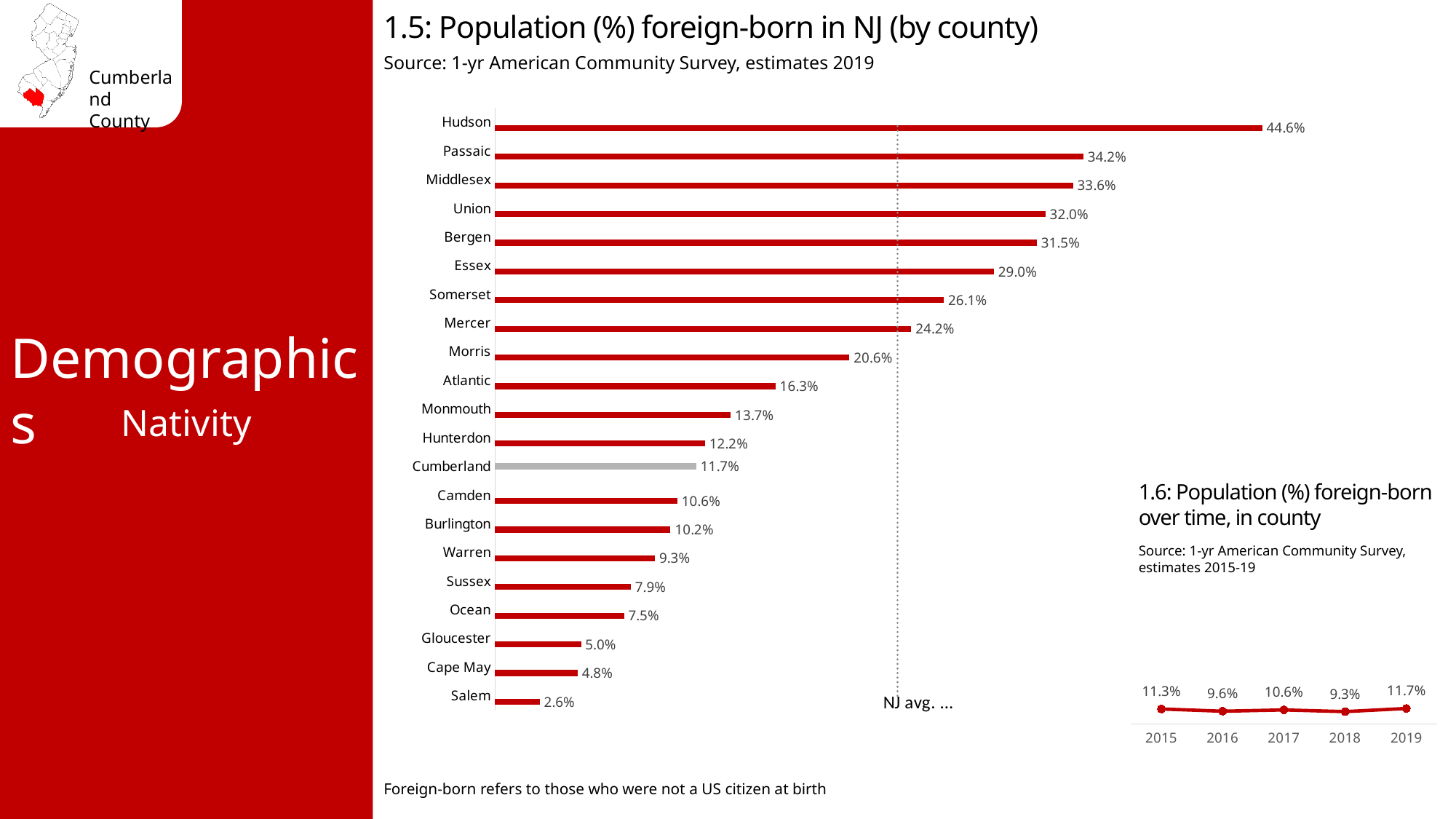
In chart 1.5, which county has the lowest foreign-born population percentage? Salem In chart 1.5, which county has the highest foreign-born population percentage? Hudson In chart 1.5, which county's bar is shown in grey rather than red? Cumberland What type of chart is chart 1.5? Bar chart In chart 1.6, what was the foreign-born population percentage in 2016? 9.6% In chart 1.5, what is the foreign-born population percentage for Hudson county? 44.6% In chart 1.5, what is the foreign-born population percentage for Cumberland county? 11.7% In chart 1.5, which county has a larger foreign-born percentage, Camden or Burlington? Camden In chart 1.5, what is the difference between the values for Passaic and Middlesex? 0.6% In chart 1.6, which year has the highest foreign-born population percentage? 2019 In chart 1.6, what is the difference between the 2019 and 2018 values? 2.4% In chart 1.5, how many counties are shown? 21